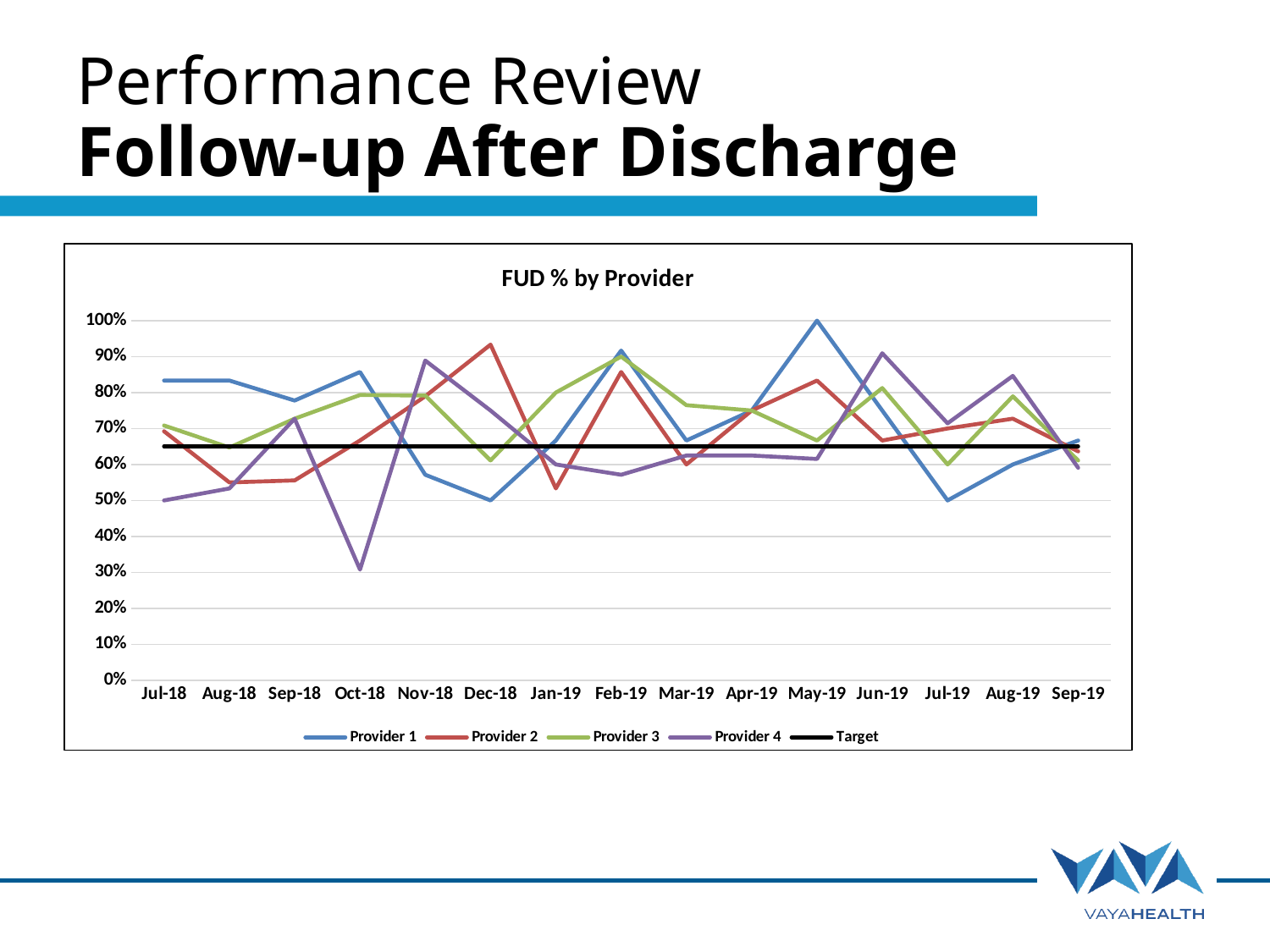
Is the value for Provider 1 in Jul-18 greater or less than 80%? greater How many months are shown along the x axis? 15 Is the value for Provider 4 in Oct-18 greater or less than 40%? less Is the value for Provider 2 in Dec-18 greater or less than 90%? greater What kind of chart is shown on the slide? line chart What is the title of the chart? FUD % by Provider Does the value for Provider 4 rise or fall from Oct-18 to Nov-18? rise Which provider has the lowest value in Oct-18? Provider 4 How many series does the legend list? 5 In Oct-18, which is larger: the value for Provider 1 or the value for Provider 4? Provider 1 Which provider has the highest value in May-19? Provider 1